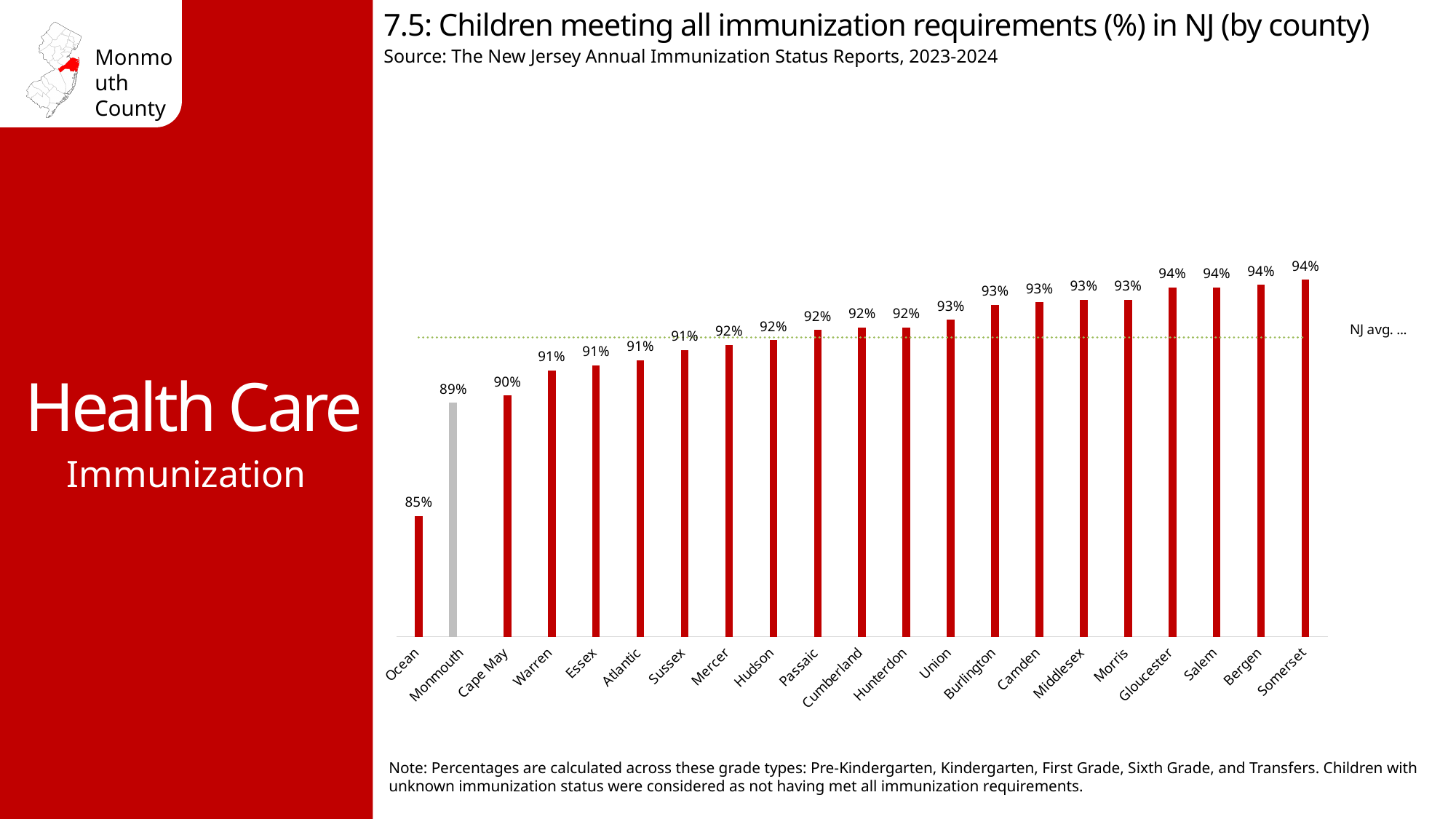
What is the difference in percentage points between Monmouth (89%) and Ocean (85%)? 4 percentage points How many counties are shown on the chart? 21 What is the value shown for Somerset County? 94% What percentage of children in Monmouth County met all immunization requirements? 89% Which county has the lowest percentage of children meeting all immunization requirements? Ocean What kind of chart is used on this slide? Bar chart What is the value shown for Ocean County? 85% Which has a higher value, Monmouth or Cape May? Cape May Do the values rise or fall moving from left to right along the x axis? Rise Which county's bar is coloured grey instead of red? Monmouth Which has a higher value, Union or Warren? Union What percentage is shown for Cape May? 90%